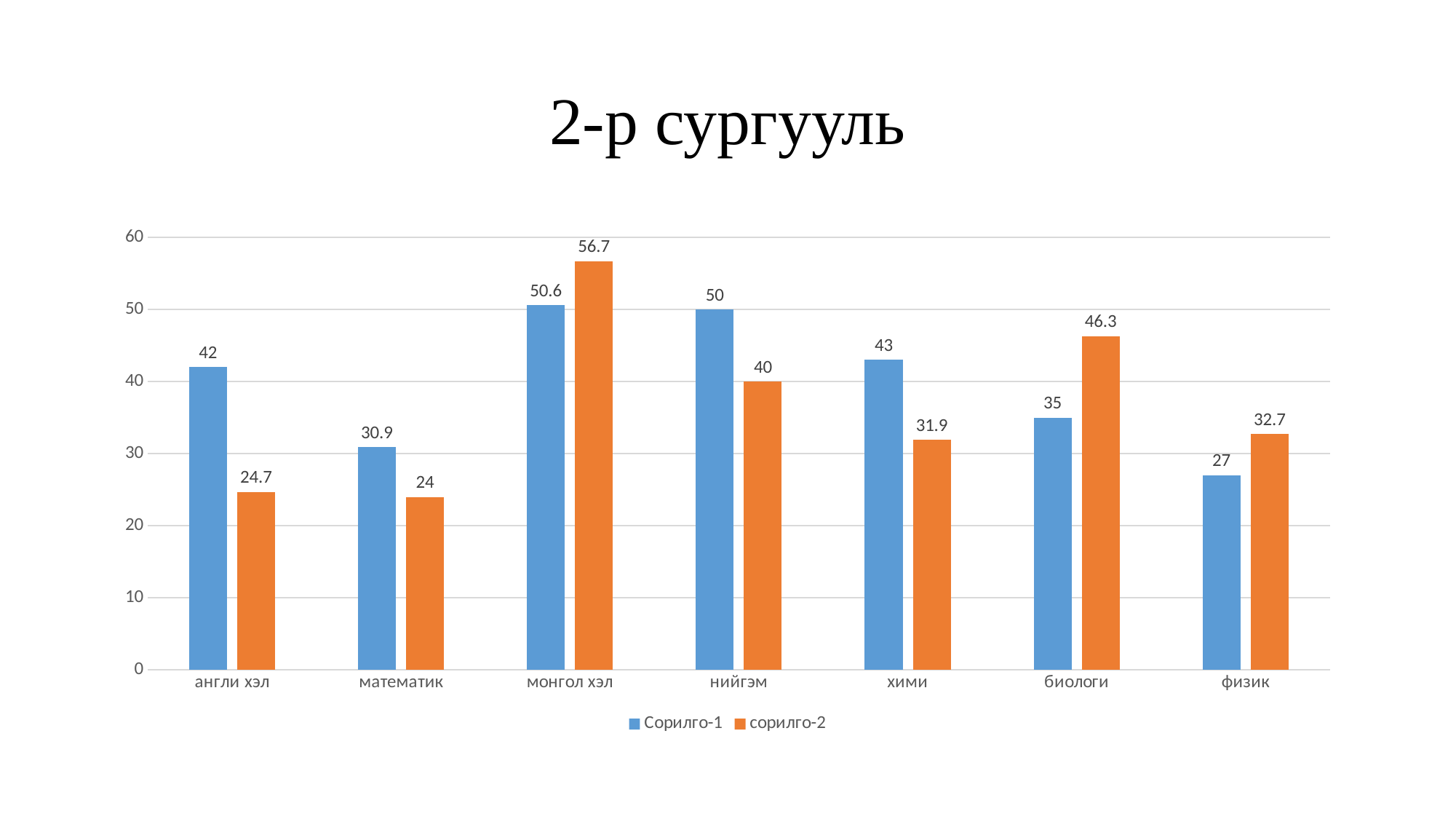
How many series does the legend list? 2 Which category has the highest сорилго-2 value? монгол хэл What is the Сорилго-1 value for математик? 30.9 Which is larger for хими: the Сорилго-1 value or the сорилго-2 value? Сорилго-1 Is the сорилго-2 value for нийгэм greater or less than 30? greater What is the сорилго-2 value for биологи? 46.3 What is the difference between the сорилго-2 and Сорилго-1 values for монгол хэл? 6.1 What is the Сорилго-1 value for англи хэл? 42 What kind of chart is shown on the slide? bar chart Which category has the lowest Сорилго-1 value? физик What is the title of the slide? 2-р сургууль How many categories are shown on the x axis? 7